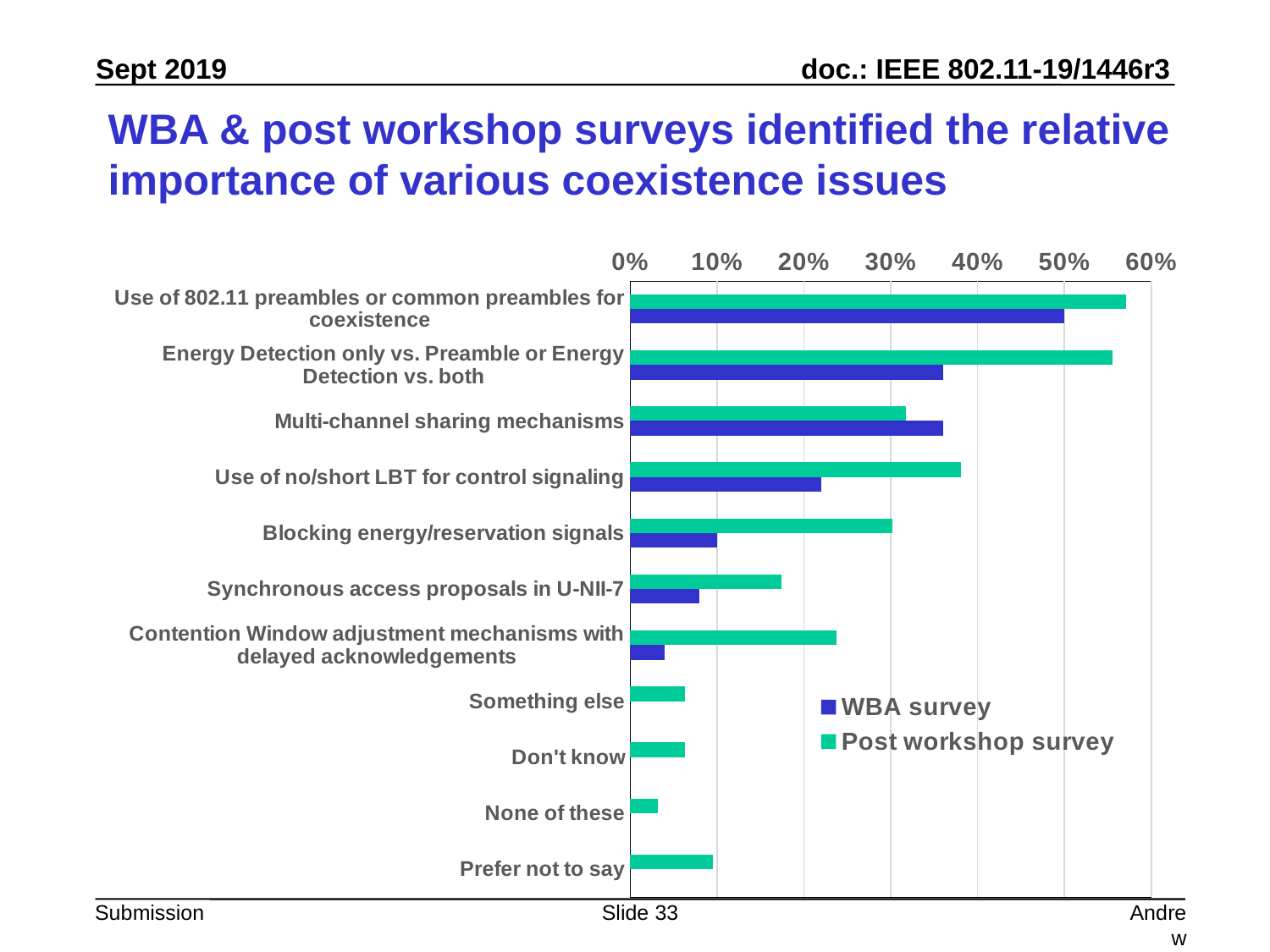
How many series does the legend list? 2 Which category has the highest value for the WBA survey? Use of 802.11 preambles or common preambles for coexistence Which category has the lowest value for the Post workshop survey? None of these Is the Post workshop survey value for Energy Detection only vs. Preamble or Energy Detection vs. both greater or less than 50%? greater For Energy Detection only vs. Preamble or Energy Detection vs. both, which series has the larger value, WBA survey or Post workshop survey? Post workshop survey How many categories are shown on the chart? 11 Is the WBA survey value for Blocking energy/reservation signals greater or less than 20%? less What kind of chart is shown on the slide? bar chart Is the Post workshop survey value for Use of no/short LBT for control signaling greater or less than 30%? greater For Contention Window adjustment mechanisms with delayed acknowledgements, which series has the larger value, WBA survey or Post workshop survey? Post workshop survey Which category has the highest value for the Post workshop survey? Use of 802.11 preambles or common preambles for coexistence Which colour represents the WBA survey series in the chart? blue